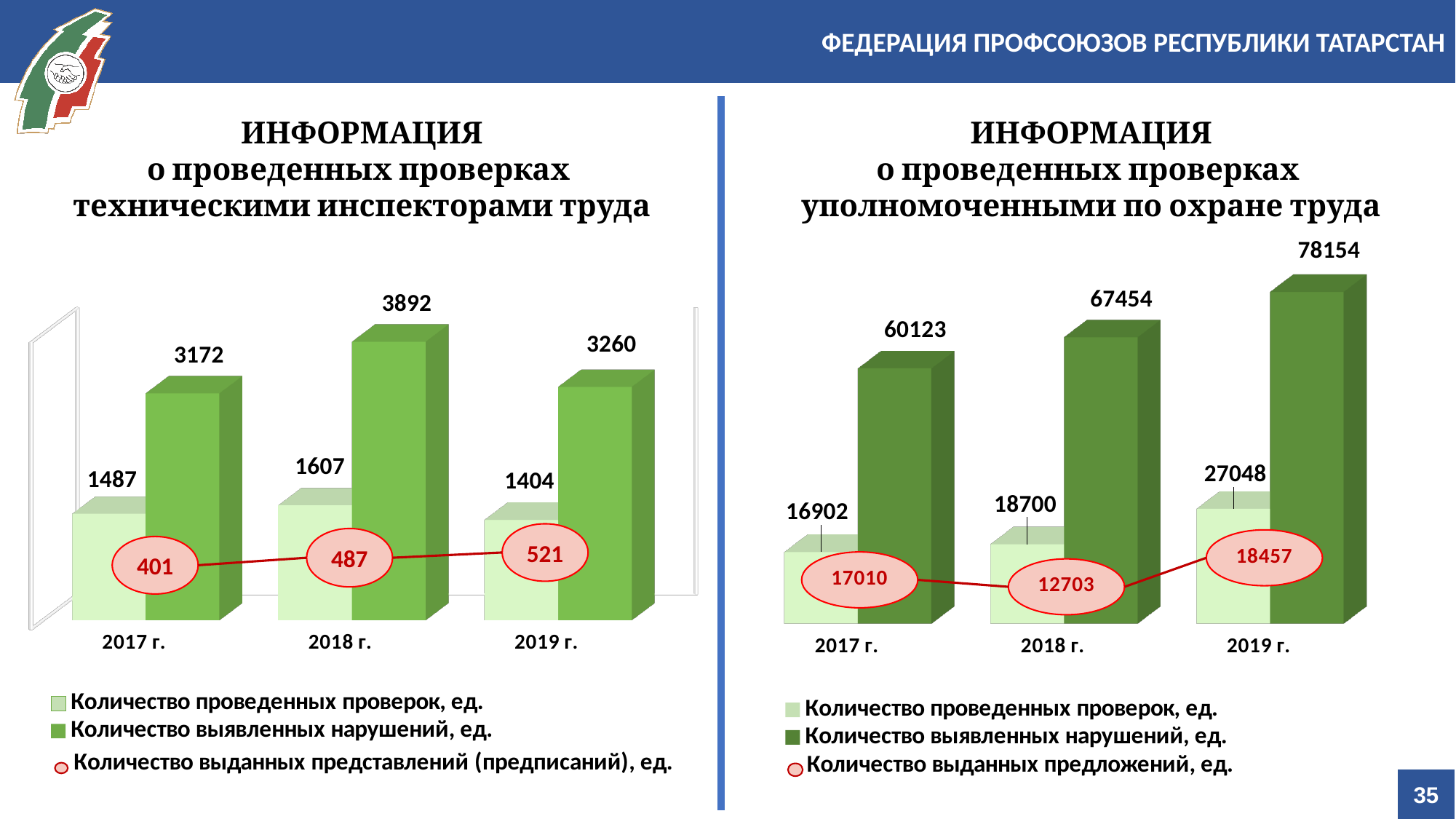
In the left chart (проверки техническими инспекторами труда), how many violations (Количество выявленных нарушений) were identified in 2018 г.? 3892 In the left chart, which year has the highest number of issued representations (Количество выданных представлений)? 2019 г. In the right chart, what is the number of issued proposals (Количество выданных предложений) for 2018 г.? 12703 In the left chart, which year has the lowest number of conducted checks? 2019 г. In the left chart, what is the difference between the number of violations identified in 2018 г. and in 2017 г.? 720 What kind of chart is used on the left side of the slide for the checks and violations? bar chart In the right chart, which year has the lowest number of issued proposals? 2018 г. In the right chart (проверки уполномоченными по охране труда), how many violations were identified in 2019 г.? 78154 In the right chart, what is the difference between the number of conducted checks in 2019 г. and in 2018 г.? 8348 How many series does the legend of the right chart list? 3 In the right chart, do the numbers of identified violations rise or fall from 2017 г. to 2019 г.? rise In the left chart, what is the number of conducted checks (Количество проведенных проверок) for 2019 г.? 1404